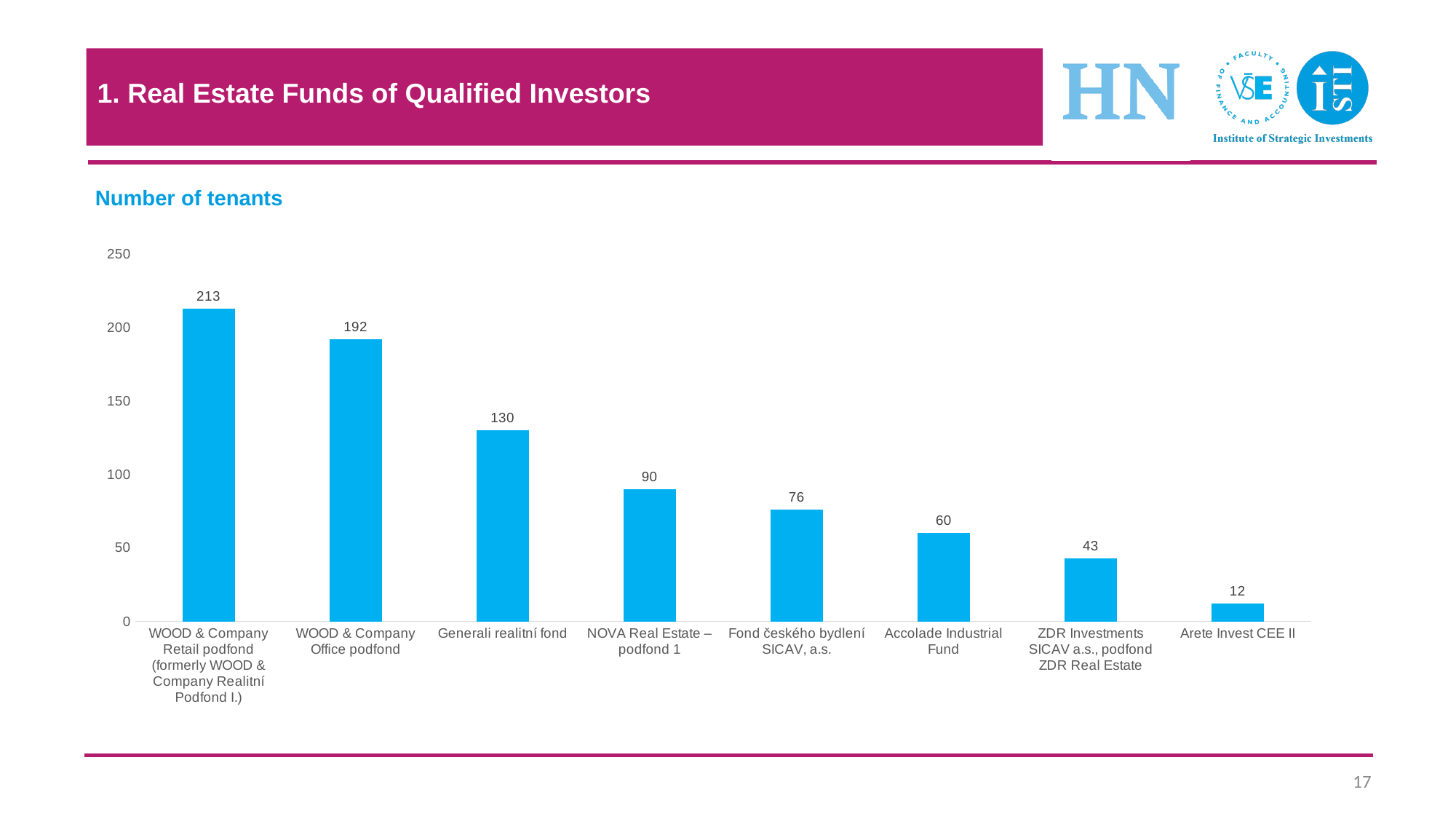
How many funds are shown in the chart? 8 What type of chart is shown on the slide? bar chart Do the values rise or fall from left to right across the chart? fall Which fund has the highest number of tenants? WOOD & Company Retail podfond (formerly WOOD & Company Realitní Podfond I.) Which fund has the lowest number of tenants? Arete Invest CEE II What is the number of tenants for Generali realitní fond? 130 What is the difference in number of tenants between NOVA Real Estate – podfond 1 and Fond českého bydlení SICAV, a.s.? 14 Is the number of tenants for Fond českého bydlení SICAV, a.s. greater or less than 100? less Which has more tenants, Generali realitní fond or NOVA Real Estate – podfond 1? Generali realitní fond What is the difference in number of tenants between WOOD & Company Retail podfond and WOOD & Company Office podfond? 21 What is the number of tenants for ZDR Investments SICAV a.s., podfond ZDR Real Estate? 43 What is the number of tenants for Accolade Industrial Fund? 60